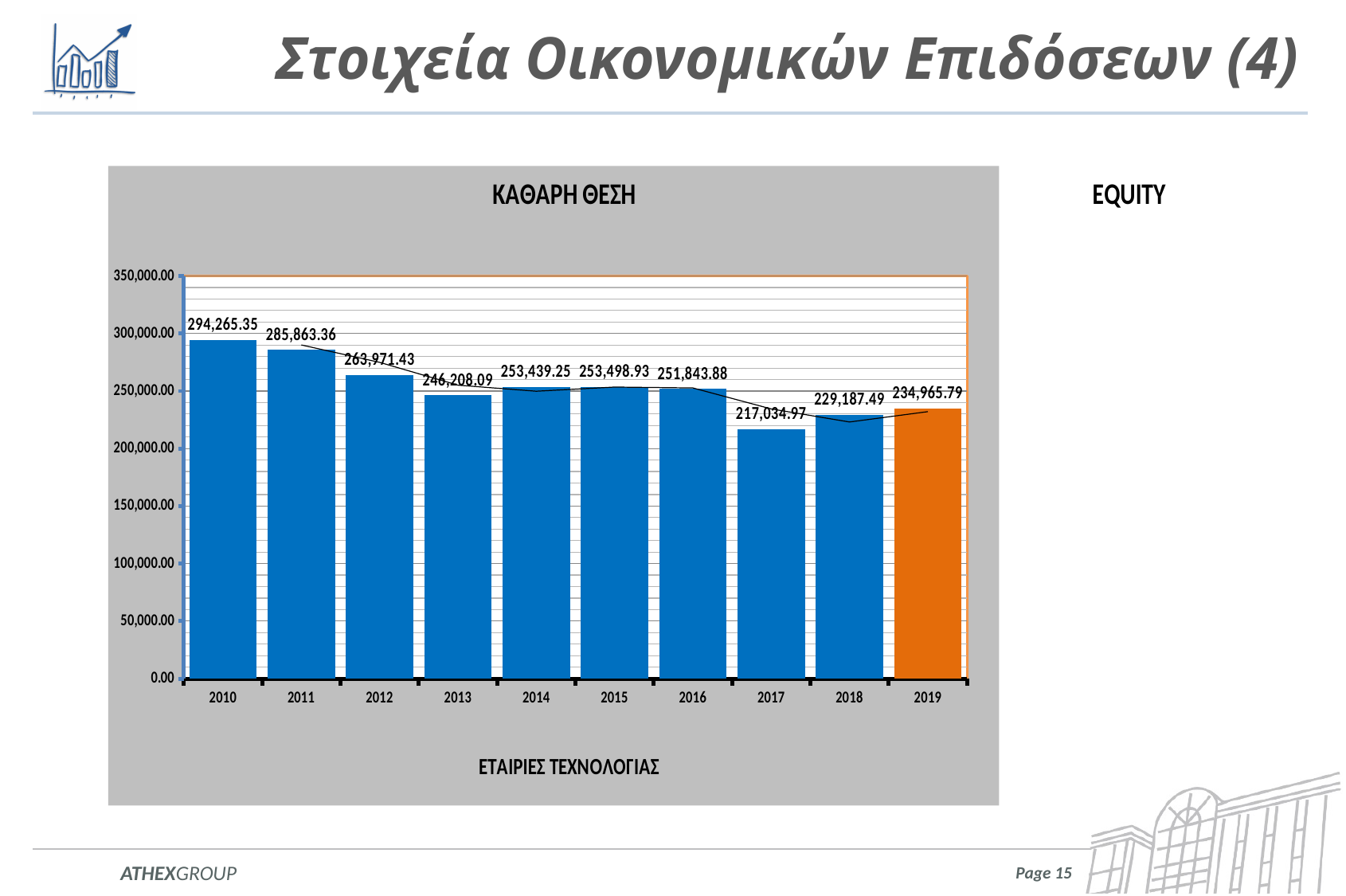
Which year has the highest value in the ΚΑΘΑΡΗ ΘΕΣΗ chart? 2010 What is the value for 2017 in the ΚΑΘΑΡΗ ΘΕΣΗ chart? 217,034.97 What is the value for 2010 in the ΚΑΘΑΡΗ ΘΕΣΗ chart? 294,265.35 How many years are shown on the x axis of the ΚΑΘΑΡΗ ΘΕΣΗ chart? 10 What is the value for 2019 in the ΚΑΘΑΡΗ ΘΕΣΗ chart? 234,965.79 Does the value in the ΚΑΘΑΡΗ ΘΕΣΗ chart rise or fall from 2010 to 2013? Fall What kind of chart is the ΚΑΘΑΡΗ ΘΕΣΗ chart? Bar chart Which is larger in the ΚΑΘΑΡΗ ΘΕΣΗ chart, the value for 2012 or the value for 2019? 2012 By how much did the value increase from 2018 to 2019 in the ΚΑΘΑΡΗ ΘΕΣΗ chart? 5,778.30 Which year has the lowest value in the ΚΑΘΑΡΗ ΘΕΣΗ chart? 2017 What is the difference between the 2010 and 2011 values in the ΚΑΘΑΡΗ ΘΕΣΗ chart? 8,401.99 Is the value for 2017 in the ΚΑΘΑΡΗ ΘΕΣΗ chart greater or less than 250,000.00? less